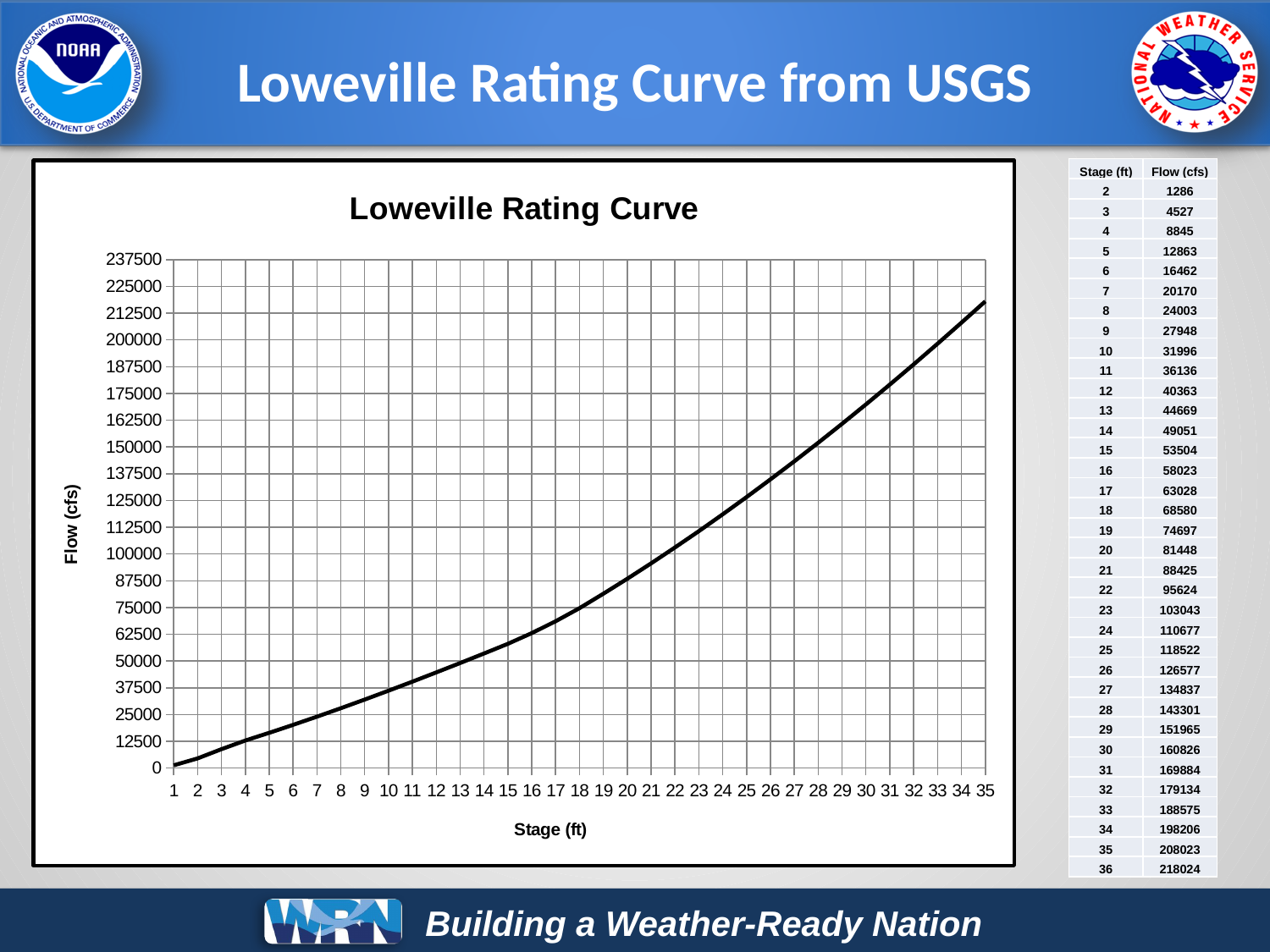
On the chart, is the flow at the right-hand end of the curve (stage 35) greater or less than 200000? greater What is the title of the chart on the slide? Loweville Rating Curve What kind of chart is the Loweville Rating Curve? line chart On the chart, is the flow at stage 10 greater or less than 25000? greater On the chart, is the flow at stage 20 greater or less than 100000? less How many stage values are labelled along the x axis of the chart? 35 According to the table beside the chart, which stage has the lowest flow? 2 What is the label of the y axis of the chart? Flow (cfs) Does the flow rise or fall as stage increases along the x axis? rises According to the table beside the chart, what is the flow (cfs) at a stage of 36 ft? 218024 According to the table beside the chart, what is the flow (cfs) at a stage of 10 ft? 31996 According to the table beside the chart, which is larger: the flow at stage 20 ft or at stage 25 ft? stage 25 ft